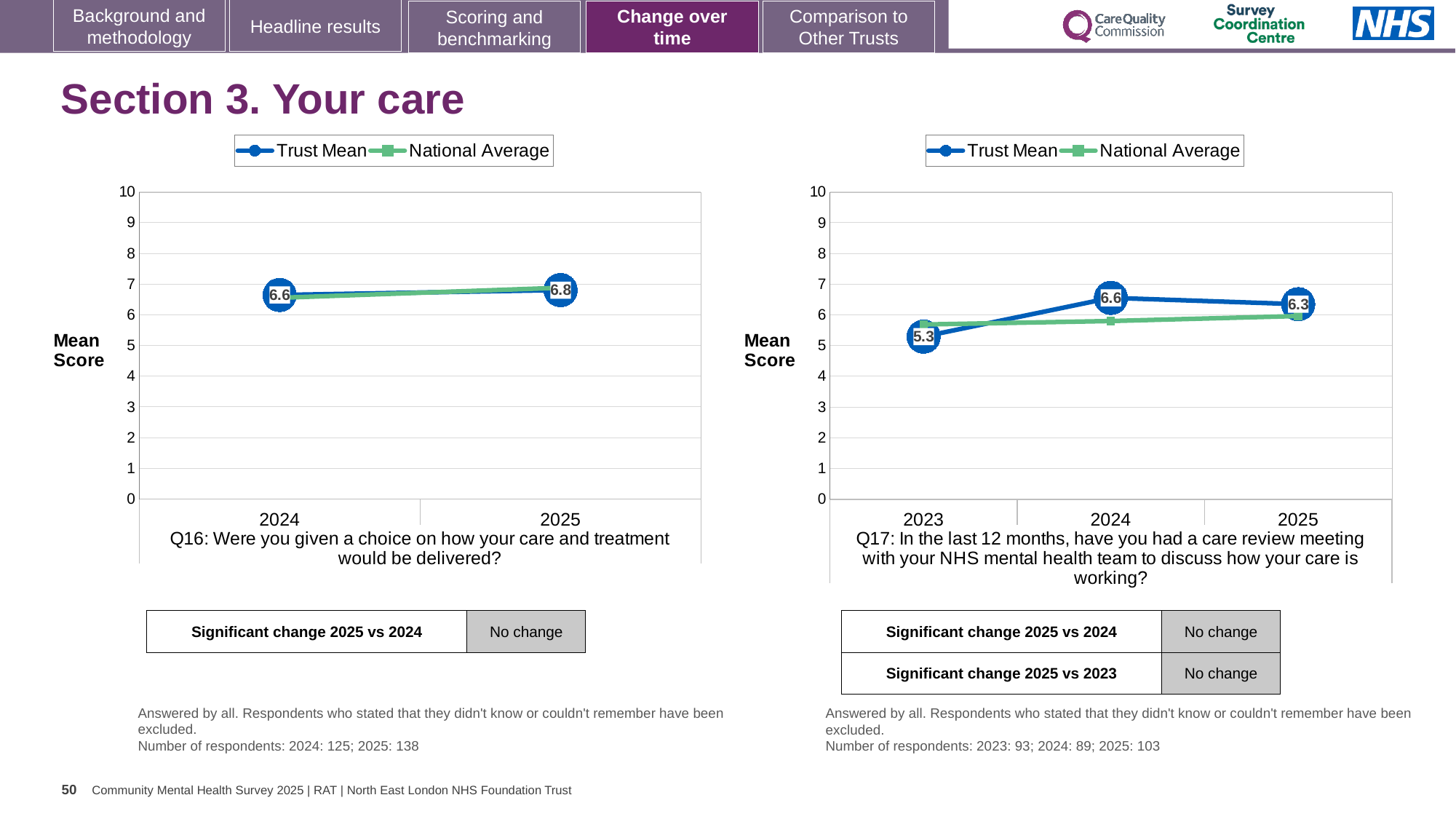
On the Q16 chart (left), what is the Trust Mean for 2024? 6.6 On the Q17 chart (right), what is the difference between the Trust Mean for 2024 and 2023? 1.3 On the Q17 chart (right), which year has the lowest Trust Mean? 2023 How many years are plotted on the Q17 chart (right)? 3 On the Q17 chart (right), what is the Trust Mean for 2024? 6.6 On the Q16 chart (left), is the Trust Mean higher in 2024 or 2025? 2025 On the Q16 chart (left), what is the Trust Mean for 2025? 6.8 On the Q17 chart (right), which year has the highest Trust Mean? 2024 On the Q17 chart (right), what is the Trust Mean for 2025? 6.3 On the Q17 chart (right), is the National Average for 2023 greater or less than 5? greater What type of chart is the Q16 chart (left)? Line chart On the Q17 chart (right), what is the Trust Mean for 2023? 5.3